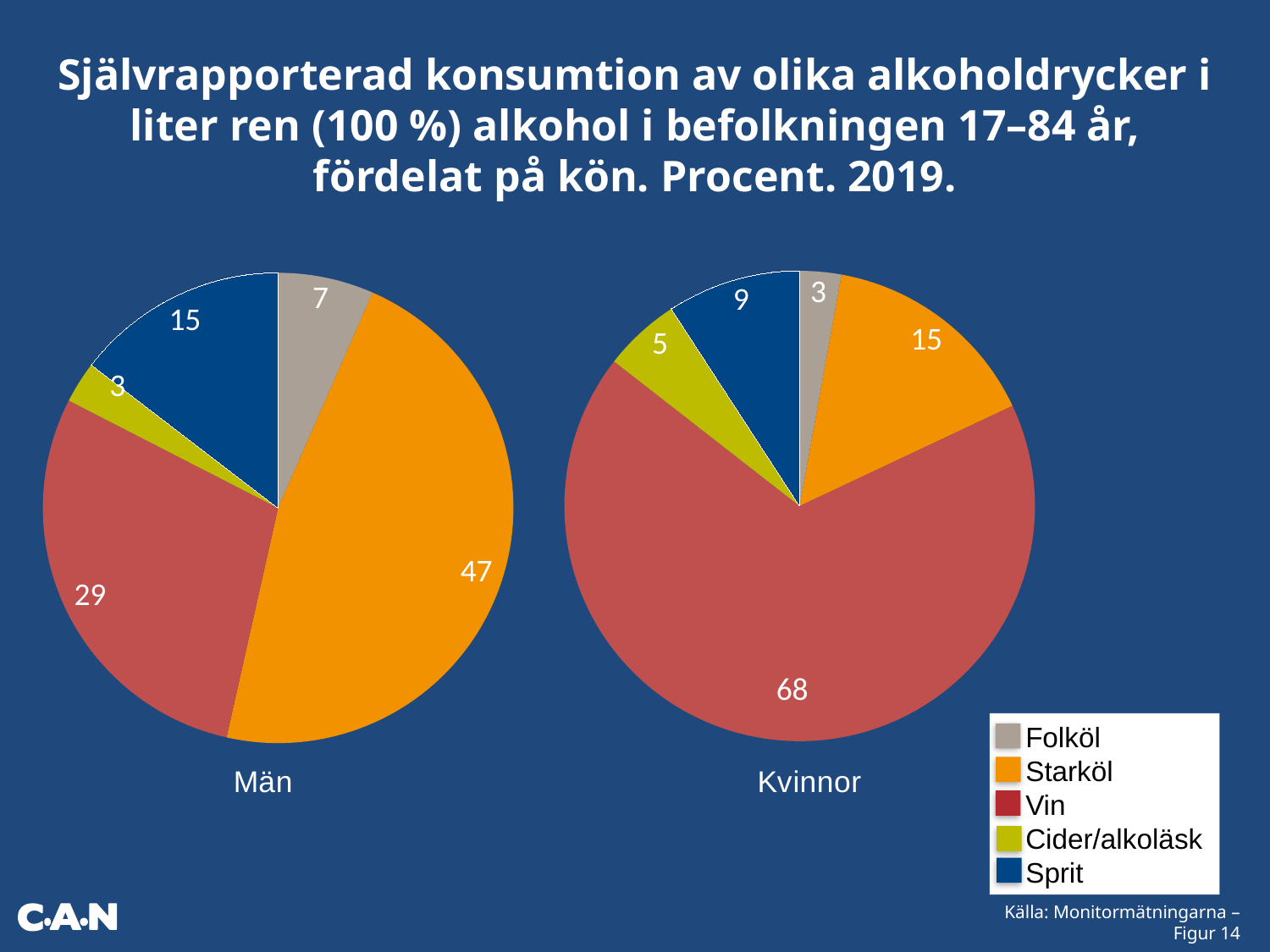
In the Män pie chart, what is the difference between the Starköl and Vin values? 18 In the Kvinnor pie chart, what is the value for Cider/alkoläsk? 5 What type of chart is used on this slide? Pie chart In the Kvinnor pie chart, which category has the smallest slice? Folköl In the Män pie chart, which category has the largest slice? Starköl Which colour represents Vin in the legend? Red In the Män pie chart, what is the value for Starköl? 47 Which is larger: the Sprit value in the Män chart or the Sprit value in the Kvinnor chart? Män How many slices does the Kvinnor pie chart have? 5 In the Män pie chart, what is the value for Sprit? 15 In the Kvinnor pie chart, what is the value for Vin? 68 In the Kvinnor pie chart, what is the difference between the Starköl and Sprit values? 6